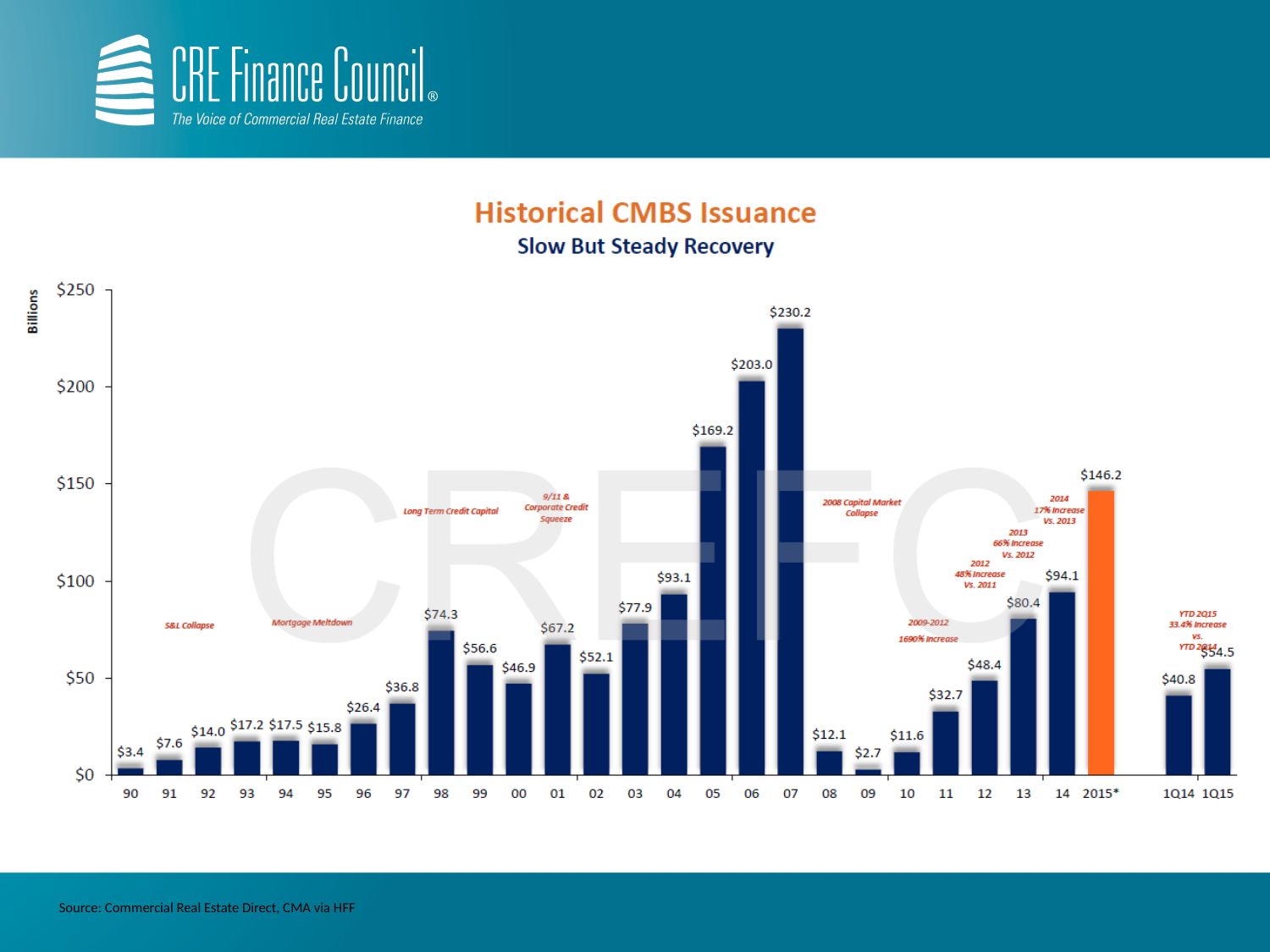
What is the value for 2007 in the Historical CMBS Issuance chart? $230.2 Which year has the highest CMBS issuance in the chart? 07 What is the difference between the values for 2014 and 2013? $13.7 Is the value for 2006 greater or less than $200? greater What kind of chart is shown on the slide? Bar chart Which year has the lowest CMBS issuance in the chart? 09 What is the value shown for 2015* in the chart? $146.2 Which is larger, the value for 1998 or the value for 2003? 2003 How many bars are plotted in the chart, including the quarterly bars? 28 What is the value for 1Q15? $54.5 Do the values rise or fall from 1990 to 2007? Rise What is the difference between the values for 1Q15 and 1Q14? $13.7